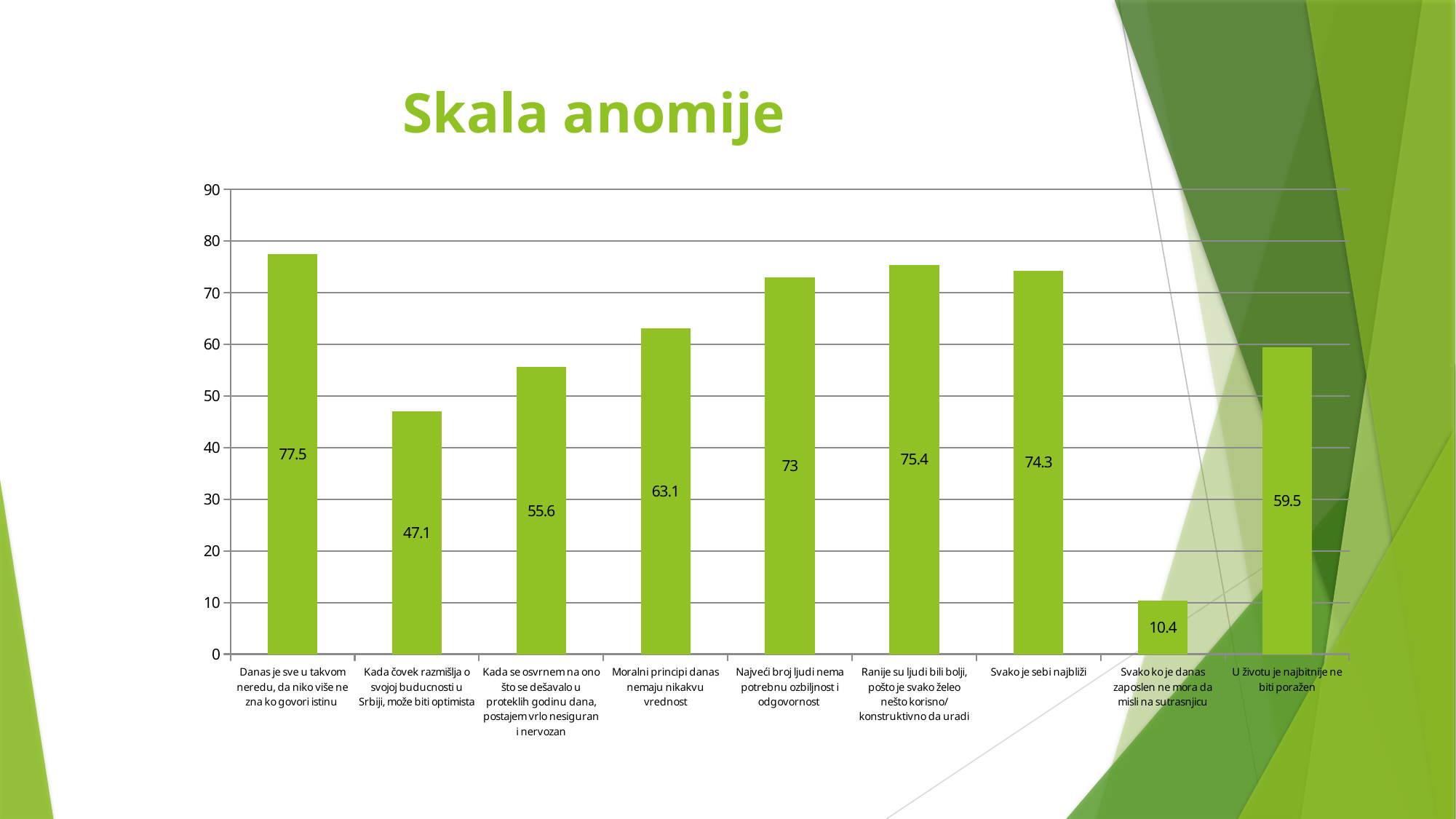
What kind of chart is shown on the slide? bar chart What is the difference between the values for "Danas je sve u takvom neredu, da niko više ne zna ko govori istinu" and "Kada čovek razmišlja o svojoj buducnosti u Srbiji, može biti optimista"? 30.4 Which category has the lowest value? Svako ko je danas zaposlen ne mora da misli na sutrasnjicu Which is larger: the value for "Kada se osvrnem na ono što se dešavalo u proteklih godinu dana, postajem vrlo nesiguran i nervozan" or the value for "U životu je najbitnije ne biti poražen"? U životu je najbitnije ne biti poražen What is the value for "Svako ko je danas zaposlen ne mora da misli na sutrasnjicu"? 10.4 What is the difference between the values for "Ranije su ljudi bili bolji, pošto je svako želeo nešto korisno/ konstruktivno da uradi" and "Najveći broj ljudi nema potrebnu ozbiljnost i odgovornost"? 2.4 Is the value for "Najveći broj ljudi nema potrebnu ozbiljnost i odgovornost" greater or less than 70? greater What is the value for "Svako je sebi najbliži"? 74.3 Which category has the highest value? Danas je sve u takvom neredu, da niko više ne zna ko govori istinu What is the title of the chart? Skala anomije How many categories are shown in the chart? 9 What is the value for "Moralni principi danas nemaju nikakvu vrednost"? 63.1